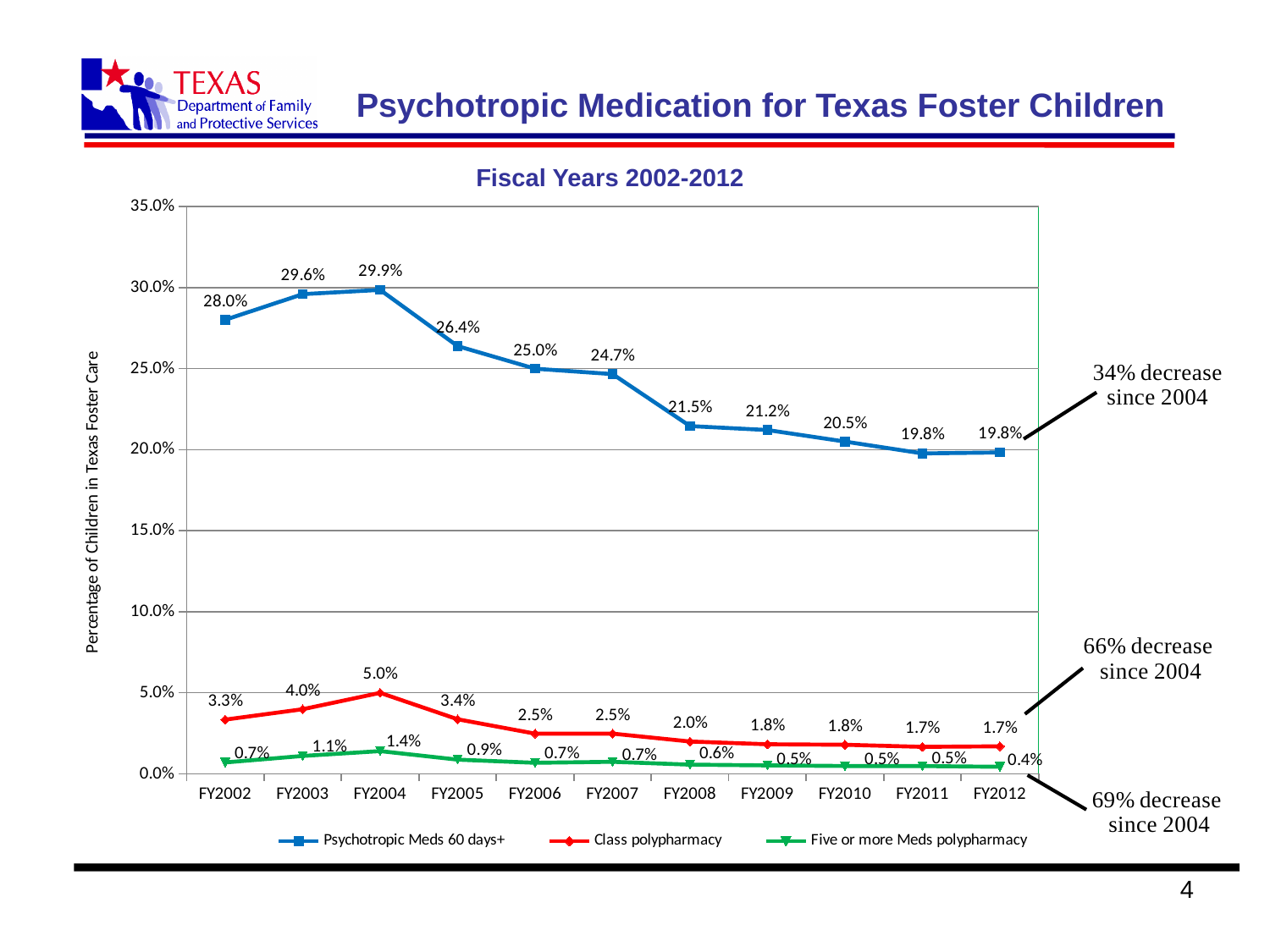
How many series does the legend list? 3 In which fiscal year is the Class polypharmacy series highest? FY2004 In which fiscal year is the Psychotropic Meds 60 days+ series highest? FY2004 Which is larger: Class polypharmacy in FY2002 or Class polypharmacy in FY2008? FY2002 What is the value for Class polypharmacy in FY2012? 1.7% What is the value for Psychotropic Meds 60 days+ in FY2004? 29.9% What is the value for Five or more Meds polypharmacy in FY2005? 0.9% How many fiscal years are shown on the x axis? 11 What is the difference between the Psychotropic Meds 60 days+ values in FY2004 and FY2012? 10.1% Is the value for Psychotropic Meds 60 days+ in FY2006 greater or less than 20.0%? greater What kind of chart is shown on the slide? line chart Does the Psychotropic Meds 60 days+ series rise or fall from FY2004 to FY2012? fall